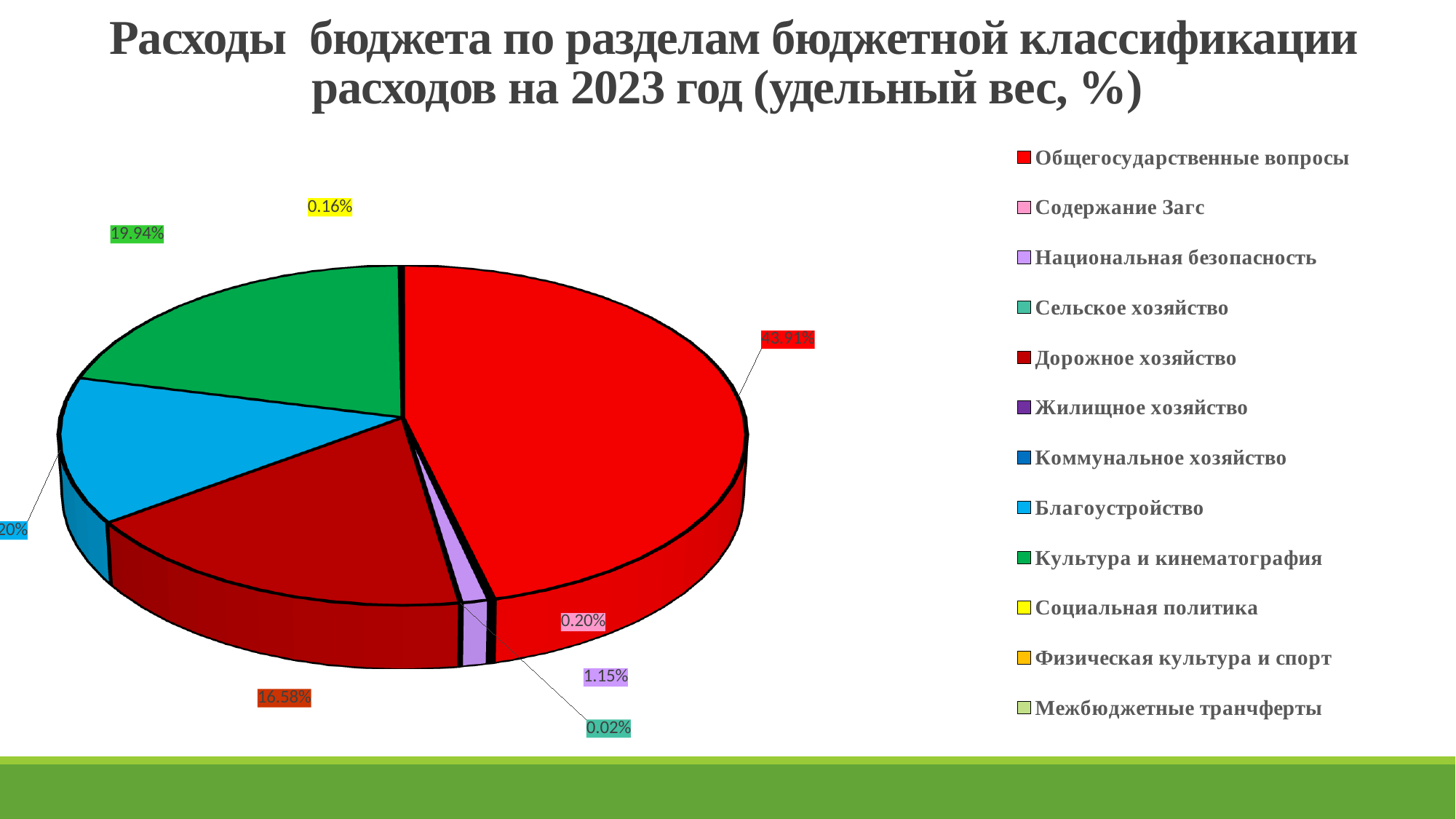
What colour is the slice for Благоустройство? light blue Which category has the largest share of the pie? Общегосударственные вопросы What kind of chart is shown on the slide? pie chart What is the share for Общегосударственные вопросы? 43.91% How many entries does the legend list? 12 What is the share for Сельское хозяйство? 0.02% What is the difference between the shares of Общегосударственные вопросы and Культура и кинематография? 23.97% What is the share for Национальная безопасность? 1.15% What is the share for Дорожное хозяйство? 16.58% What is the share for Социальная политика? 0.16% What is the share for Культура и кинематография? 19.94% Which has a larger share, Культура и кинематография or Дорожное хозяйство? Культура и кинематография